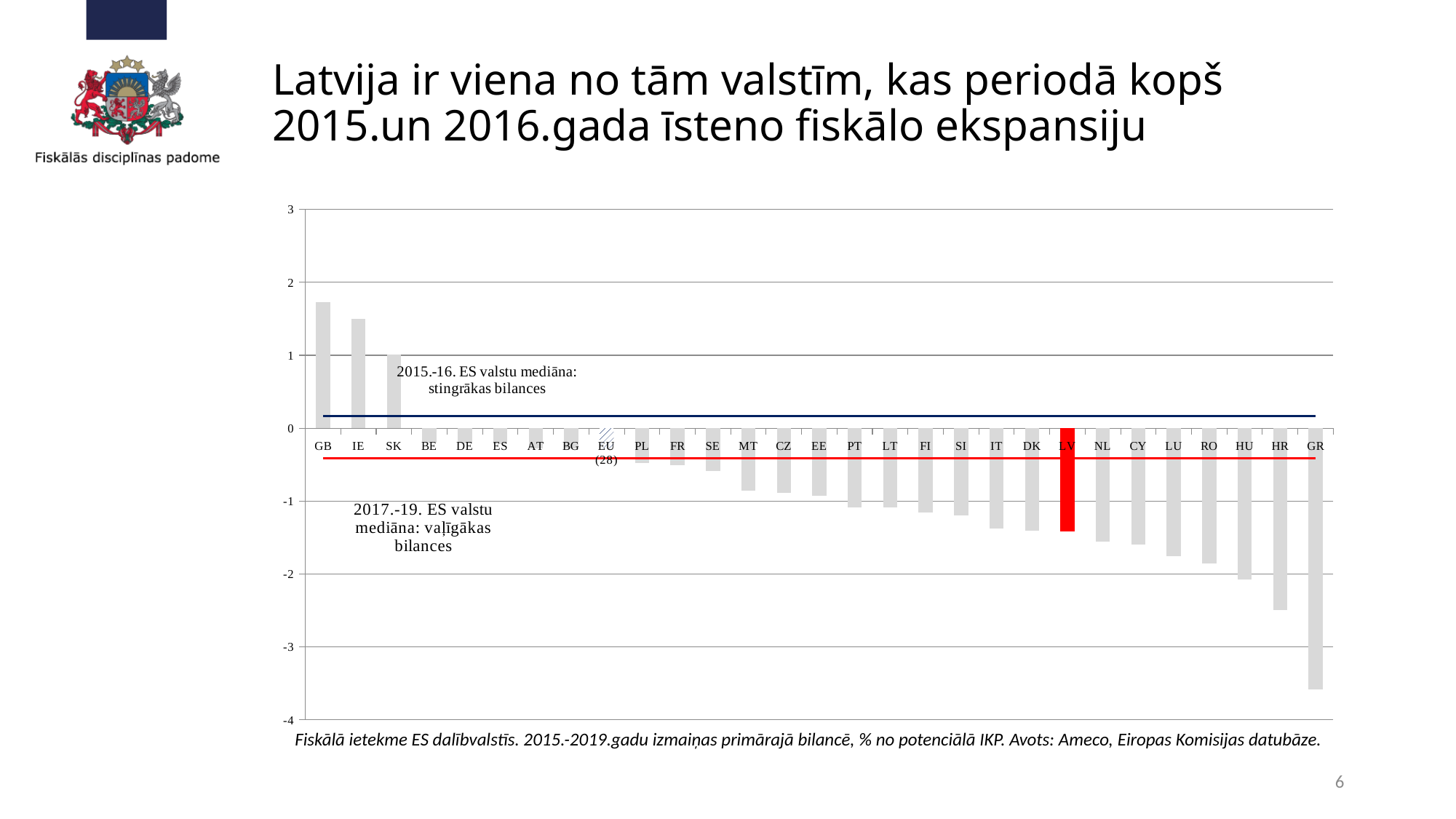
Is the value for HR greater or less than -2? less Is the value for GB greater or less than 1? greater Do the bar values rise or fall moving from left to right along the x axis? fall How many categories have a positive (above zero) bar in the chart? 3 Which category has the highest value in the chart? GB Is the value for GR greater or less than -3? less How many categories (countries/groups) are shown on the x axis of the chart? 29 Which has the larger value, GB or IE? GB What kind of chart is shown on the slide? bar chart Which country's bar is highlighted in red in the chart? LV Which category has the lowest value in the chart? GR